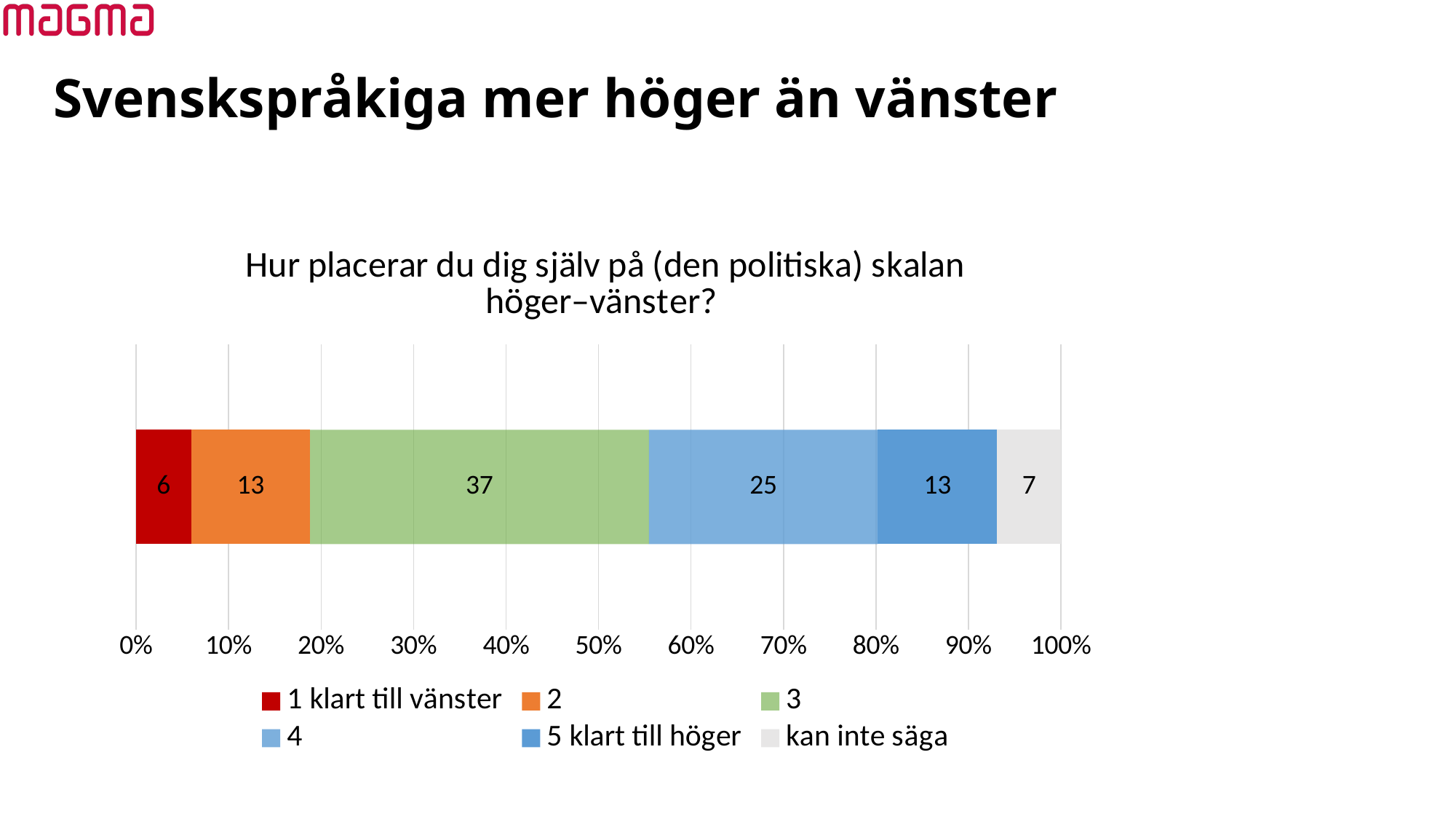
What is the value for the segment '3' in the stacked bar? 37 Which is larger, the value for segment '4' or the value for segment '2'? 4 How many series does the legend list? 6 What is the title of the chart? Hur placerar du dig själv på (den politiska) skalan höger–vänster? What is the value for the segment '5 klart till höger'? 13 What is the difference between the values for segment '3' and segment '4'? 12 What is the total of the values for segments '4' and '5 klart till höger' combined? 38 What is the value for the segment 'kan inte säga'? 7 What is the value for the segment '1 klart till vänster'? 6 Which segment has the largest value? 3 What kind of chart is shown on the slide? Stacked bar chart Which segment has the smallest value? 1 klart till vänster